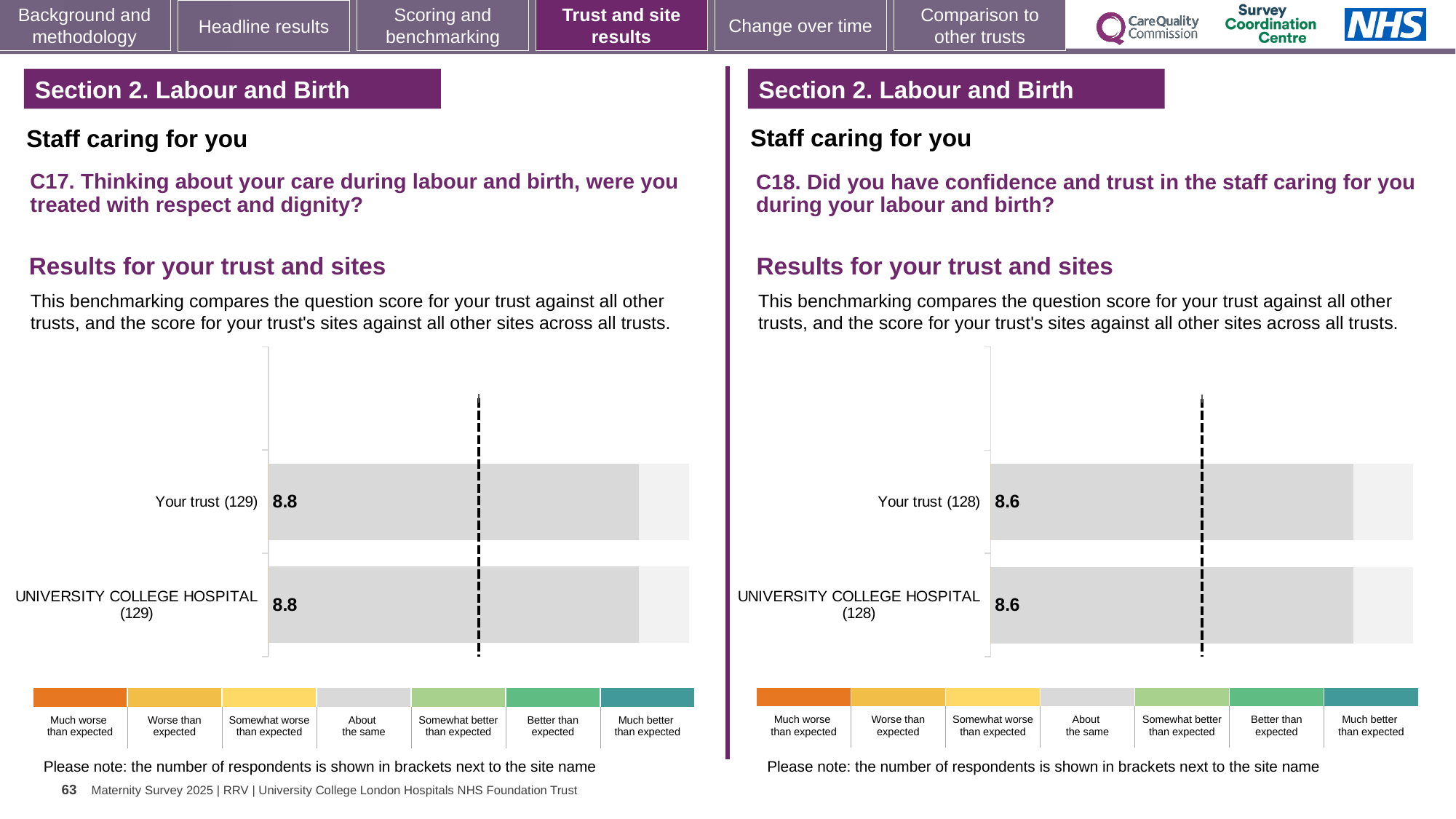
In the C18 chart on the right, what is the score for Your trust? 8.6 How many bars are plotted in the C17 chart on the left? 2 In the C18 chart on the right, what is the score for UNIVERSITY COLLEGE HOSPITAL? 8.6 What type of chart is used for the C17 results on the left? Bar chart In the C17 chart on the left, what is the score for Your trust? 8.8 In the C17 chart on the left, what is the score for UNIVERSITY COLLEGE HOSPITAL? 8.8 Is the Your trust score in the C17 chart on the left larger than the Your trust score in the C18 chart on the right? Yes How many bars are plotted in the C18 chart on the right? 2 In the C18 chart on the right, what is the difference between the Your trust score and the UNIVERSITY COLLEGE HOSPITAL score? 0 In the C18 chart on the right, how many respondents are shown in brackets for UNIVERSITY COLLEGE HOSPITAL? 128 In the C17 chart on the left, how many respondents are shown in brackets for Your trust? 129 In the C17 chart on the left, what is the difference between the Your trust score and the UNIVERSITY COLLEGE HOSPITAL score? 0